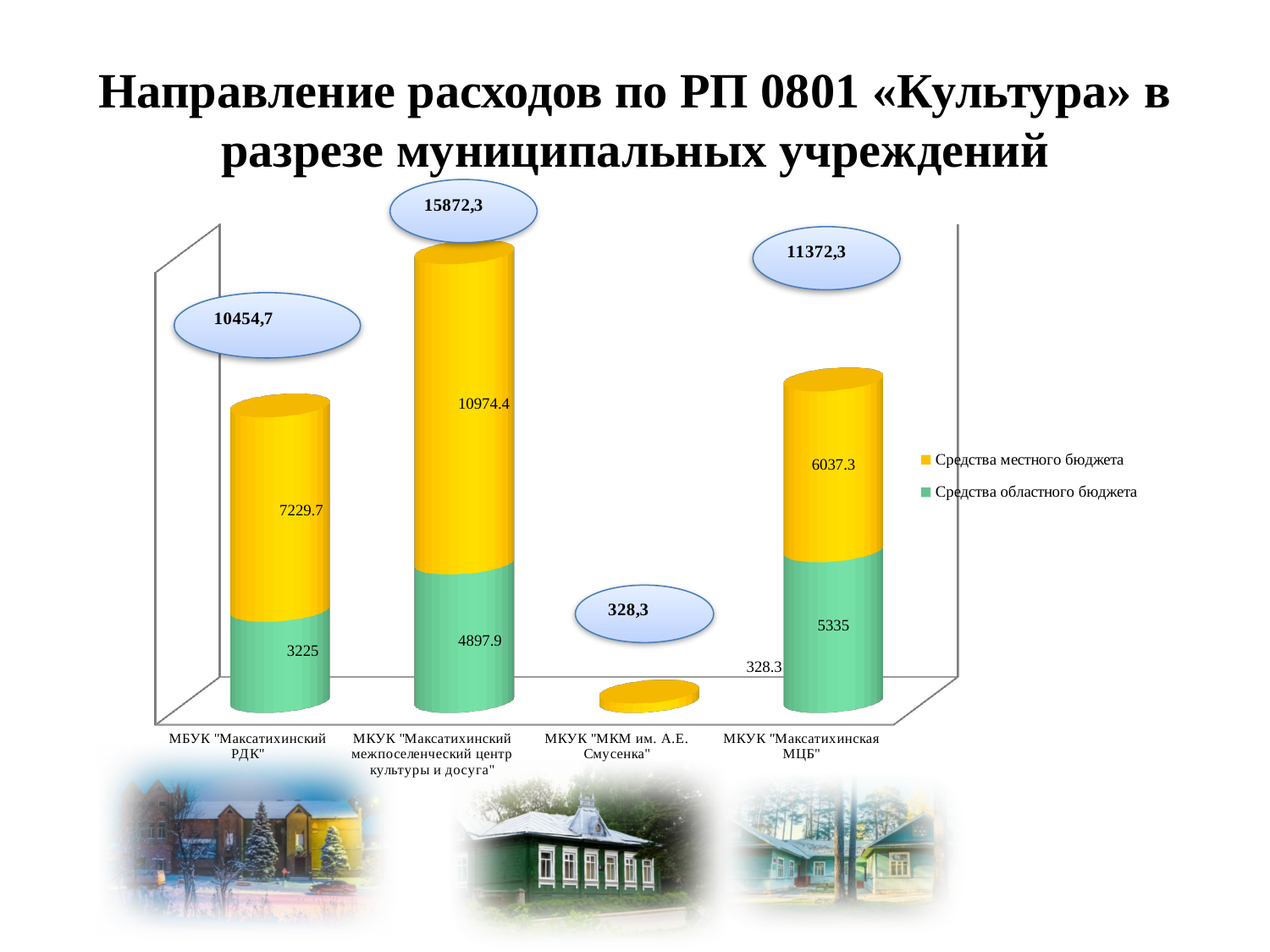
How many series does the legend list? 2 Which institution has the highest total expenditure? МКУК "Максатихинский межпоселенческий центр культуры и досуга" What is the value shown for МКУК "МКМ им. А.Е. Смусенка"? 328.3 How many institutions (categories) are shown on the x axis? 4 Which is larger for МБУК "Максатихинский РДК": "Средства местного бюджета" or "Средства областного бюджета"? Средства местного бюджета What is the value of "Средства областного бюджета" for МКУК "Максатихинский межпоселенческий центр культуры и досуга"? 4897.9 Which institution has the lowest total expenditure? МКУК "МКМ им. А.Е. Смусенка" What kind of chart is shown on the slide? Bar chart (stacked) What is the total shown in the callout above the bar for МКУК "Максатихинский межпоселенческий центр культуры и досуга"? 15872,3 What is the value of "Средства местного бюджета" for МБУК "Максатихинский РДК"? 7229.7 What is the value of "Средства областного бюджета" for МКУК "Максатихинская МЦБ"? 5335 What is the difference between "Средства местного бюджета" and "Средства областного бюджета" for МКУК "Максатихинская МЦБ"? 702.3